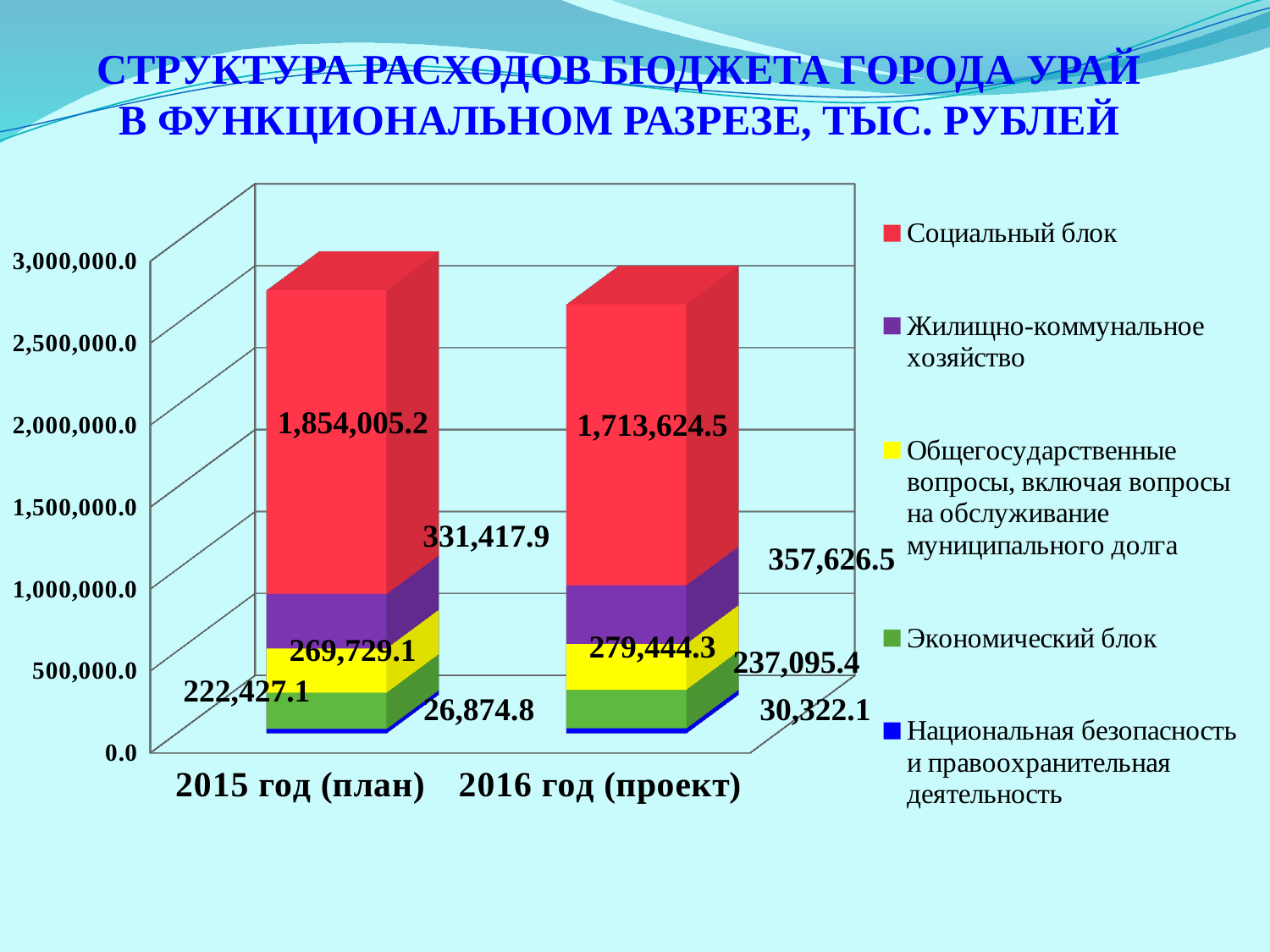
Which is larger: Общегосударственные вопросы in 2015 год (план) or in 2016 год (проект)? 2016 год (проект) What is the value of Экономический блок for 2016 год (проект)? 237,095.4 Which series has the largest value in 2016 год (проект)? Социальный блок Which series has the smallest value in 2015 год (план)? Национальная безопасность и правоохранительная деятельность How many series does the legend list? 5 What kind of chart is shown on the slide? Stacked bar chart What is the value of Жилищно-коммунальное хозяйство for 2016 год (проект)? 357,626.5 By how much does Социальный блок in 2015 год (план) exceed Социальный блок in 2016 год (проект)? 140,380.7 What is the value of Национальная безопасность и правоохранительная деятельность for 2015 год (план)? 26,874.8 What is the value of Социальный блок for 2015 год (план)? 1,854,005.2 How many categories (years) are shown on the x axis? 2 What is the total of the stacked bar for 2016 год (проект)? 2,618,112.8